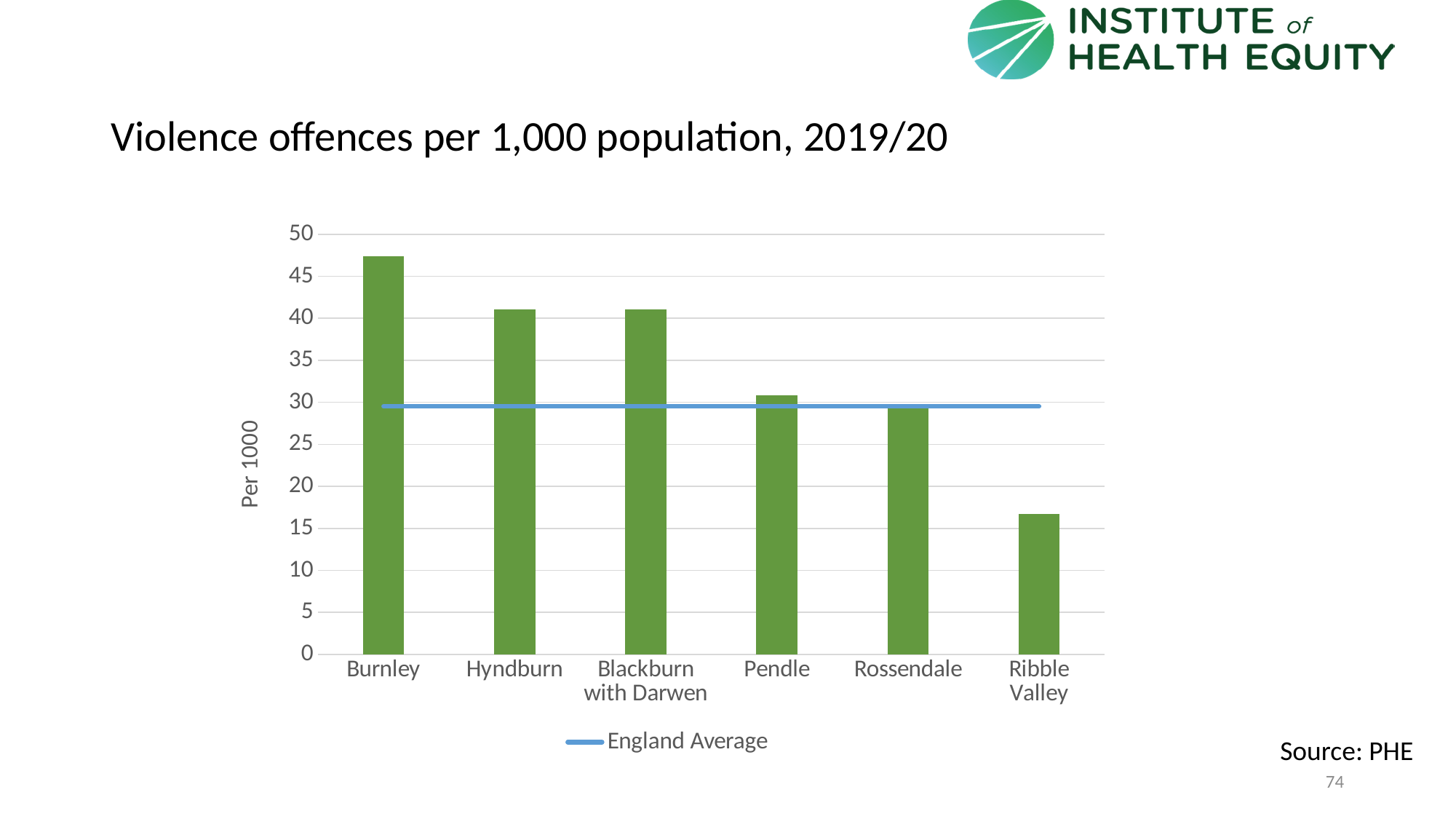
How many local authorities are shown on the x axis of the chart? 6 What kind of chart is shown on the slide? Bar chart What is the label on the y axis of the chart? Per 1000 Which local authority has the lowest rate of violence offences per 1,000 population? Ribble Valley Do the bar values rise or fall from left to right across the x axis? Fall Which local authority has the highest rate of violence offences per 1,000 population? Burnley Is the value for Rossendale greater or less than 25? greater Is the value for Ribble Valley greater or less than 20? less Is the value for Burnley greater or less than 45? greater Which has a higher rate of violence offences, Burnley or Ribble Valley? Burnley What is the only entry listed in the chart legend? England Average